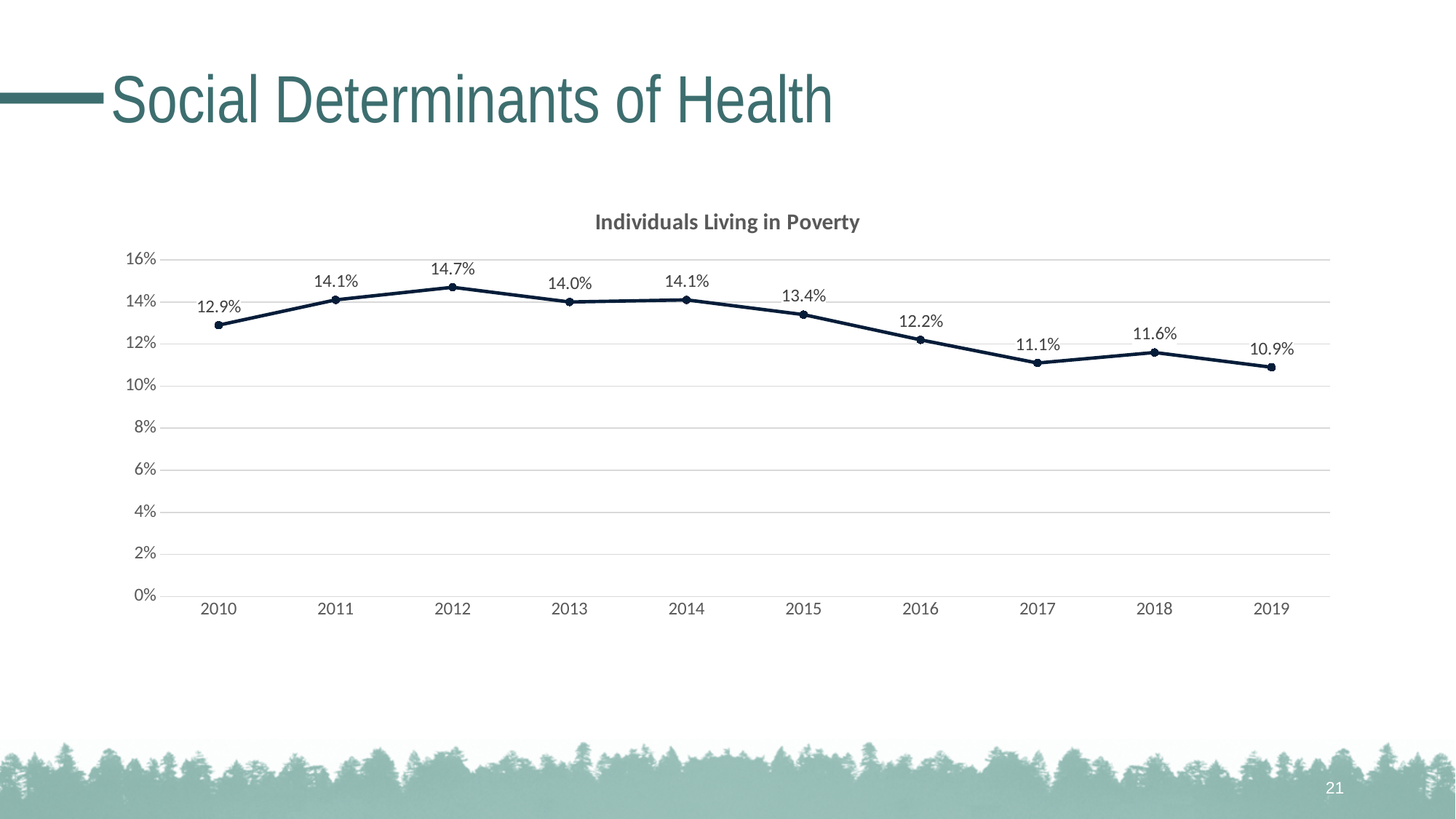
Which year has the highest value in the Individuals Living in Poverty chart? 2012 Which year has the lowest value in the Individuals Living in Poverty chart? 2019 Is the value for 2016 in the Individuals Living in Poverty chart greater or less than 14%? less What is the value for 2012 in the Individuals Living in Poverty chart? 14.7% What is the difference between the 2012 and 2019 values in the Individuals Living in Poverty chart? 3.8% What is the value for 2019 in the Individuals Living in Poverty chart? 10.9% Do the values in the Individuals Living in Poverty chart rise or fall from 2014 to 2017? fall What is the title of the chart on the slide? Individuals Living in Poverty Which is larger in the Individuals Living in Poverty chart, the value for 2017 or the value for 2018? 2018 How many years are plotted in the Individuals Living in Poverty chart? 10 What is the value for 2015 in the Individuals Living in Poverty chart? 13.4% What kind of chart is the Individuals Living in Poverty chart? line chart